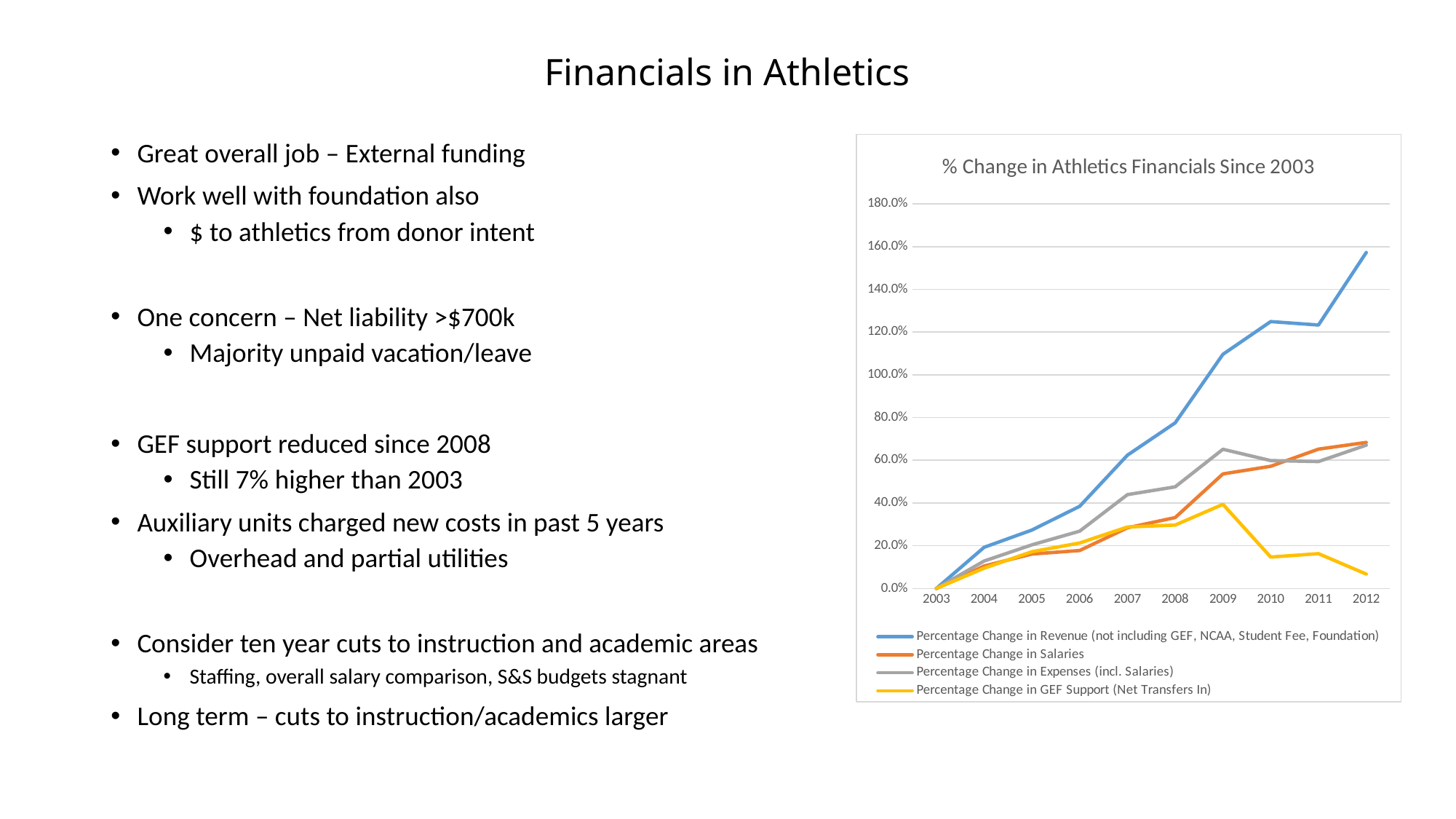
What is the title of the chart? % Change in Athletics Financials Since 2003 Is the value for Percentage Change in GEF Support (Net Transfers In) in 2012 greater or less than 20.0%? less Which series has the lowest value in 2012? Percentage Change in GEF Support (Net Transfers In) What kind of chart is shown on the slide? line chart Is the value for Percentage Change in Revenue in 2009 greater or less than 100.0%? greater Does the Percentage Change in Revenue line generally rise or fall from 2003 to 2012? rise How many series does the chart's legend list? 4 Which series has the highest value in 2012? Percentage Change in Revenue (not including GEF, NCAA, Student Fee, Foundation) Is the value for Percentage Change in Salaries in 2012 greater or less than 60.0%? greater Which is larger in 2012: Percentage Change in Revenue or Percentage Change in Expenses (incl. Salaries)? Percentage Change in Revenue How many years are plotted along the x axis of the chart? 10